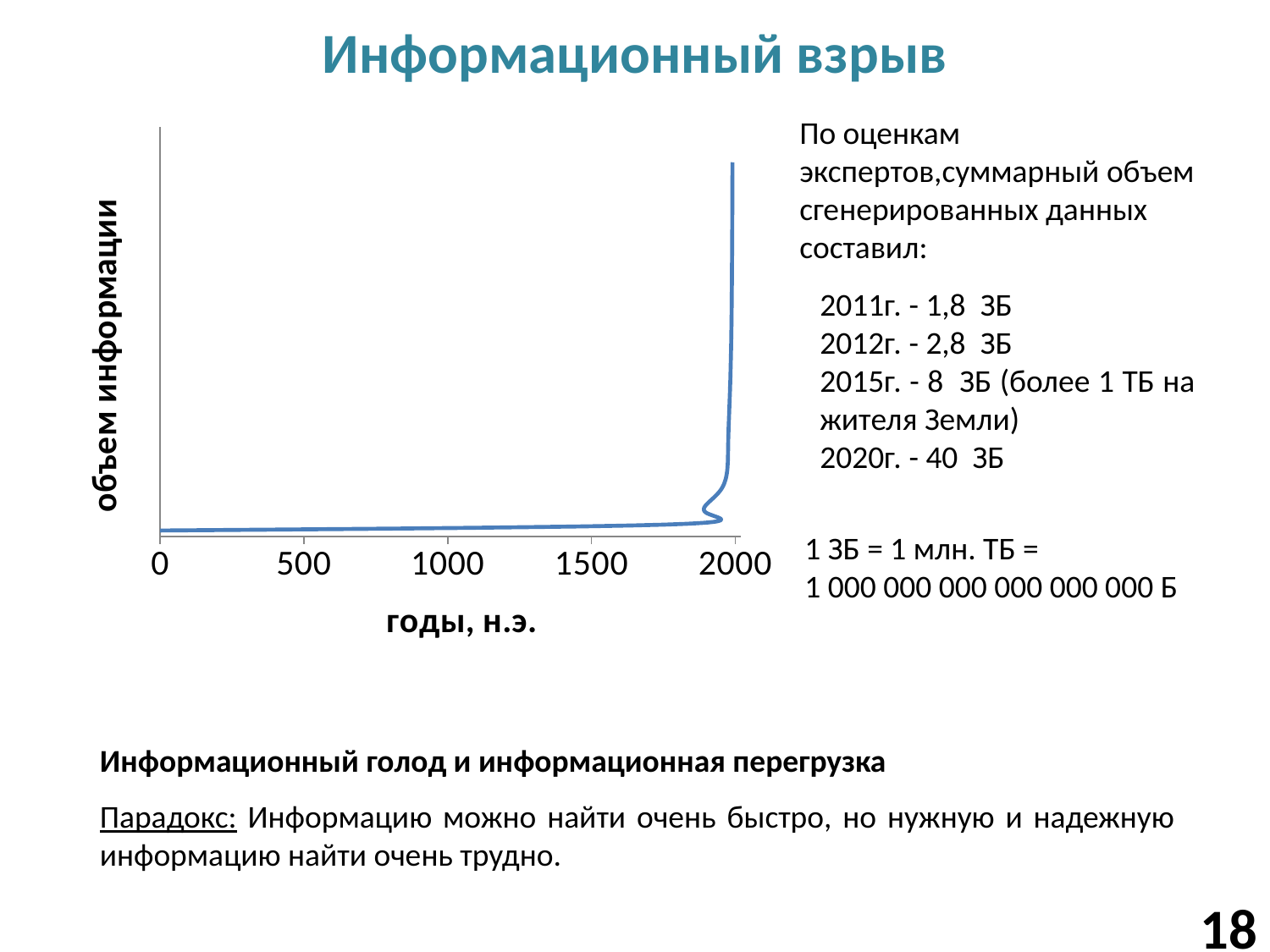
How many lines are plotted on the chart? 1 Is the value of the line at year 500 larger or smaller than its value near year 2000? smaller What is the label of the x axis of the chart? годы, н.э. Does the plotted line rise or fall as the years increase along the x axis? rise What is the label of the y axis of the chart? объем информации What kind of chart is shown on the slide? line chart